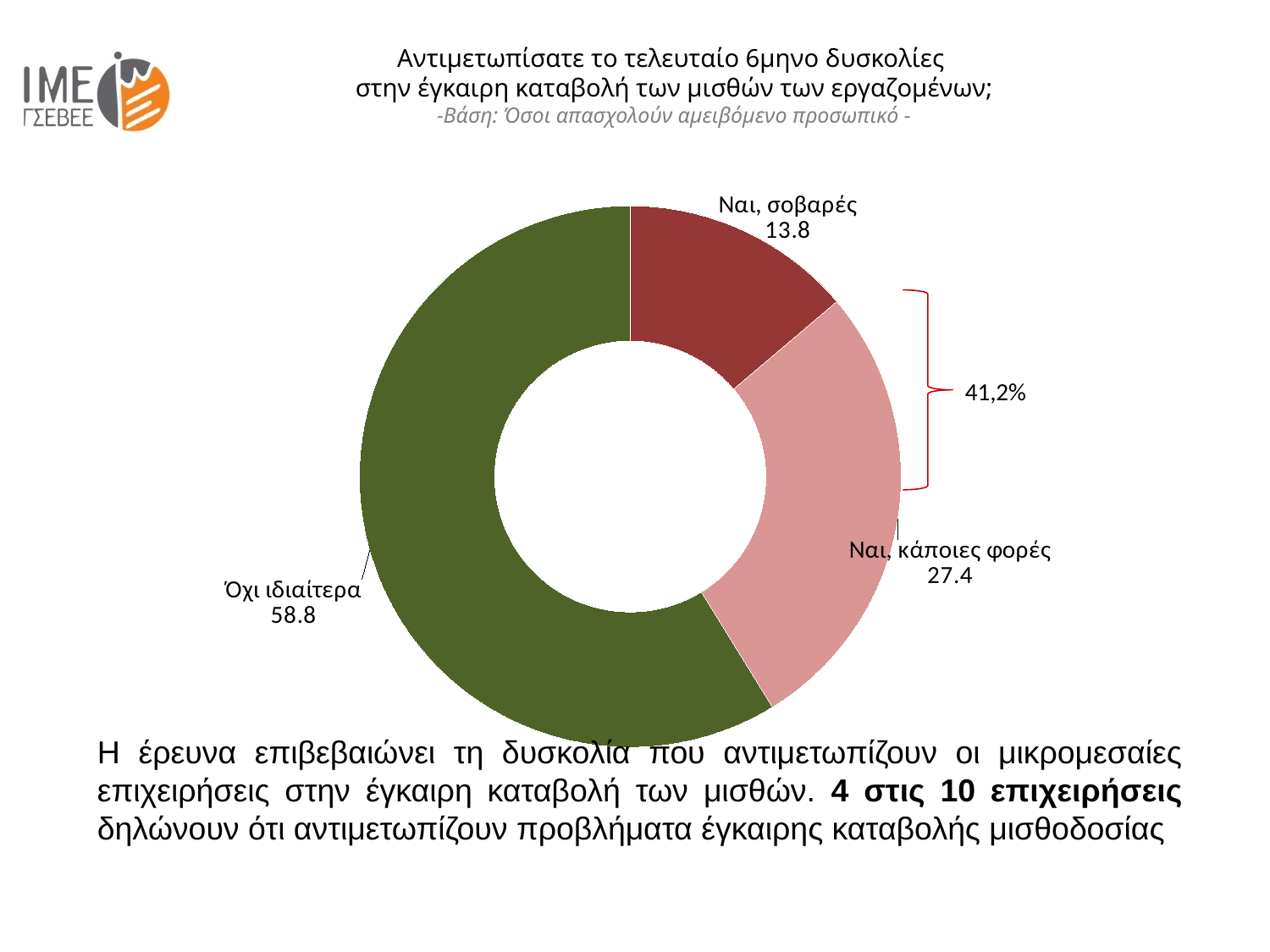
Which category has the smallest slice in the chart? Ναι, σοβαρές What value is shown for the slice labelled "Ναι, σοβαρές"? 13.8 What value is shown for the slice labelled "Όχι ιδιαίτερα"? 58.8 Which category has the largest slice in the chart? Όχι ιδιαίτερα What colour is the slice for "Όχι ιδιαίτερα"? Dark green Which is larger: the value for "Ναι, κάποιες φορές" or the value for "Ναι, σοβαρές"? Ναι, κάποιες φορές What is the difference between the values for "Όχι ιδιαίτερα" and "Ναι, κάποιες φορές"? 31.4 What percentage is shown next to the bracket grouping the two "Ναι" slices? 41,2% How many slices does the chart have? 3 What is the difference between the values for "Ναι, κάποιες φορές" and "Ναι, σοβαρές"? 13.6 What value is shown for the slice labelled "Ναι, κάποιες φορές"? 27.4 What kind of chart is shown on the slide? Doughnut (pie) chart